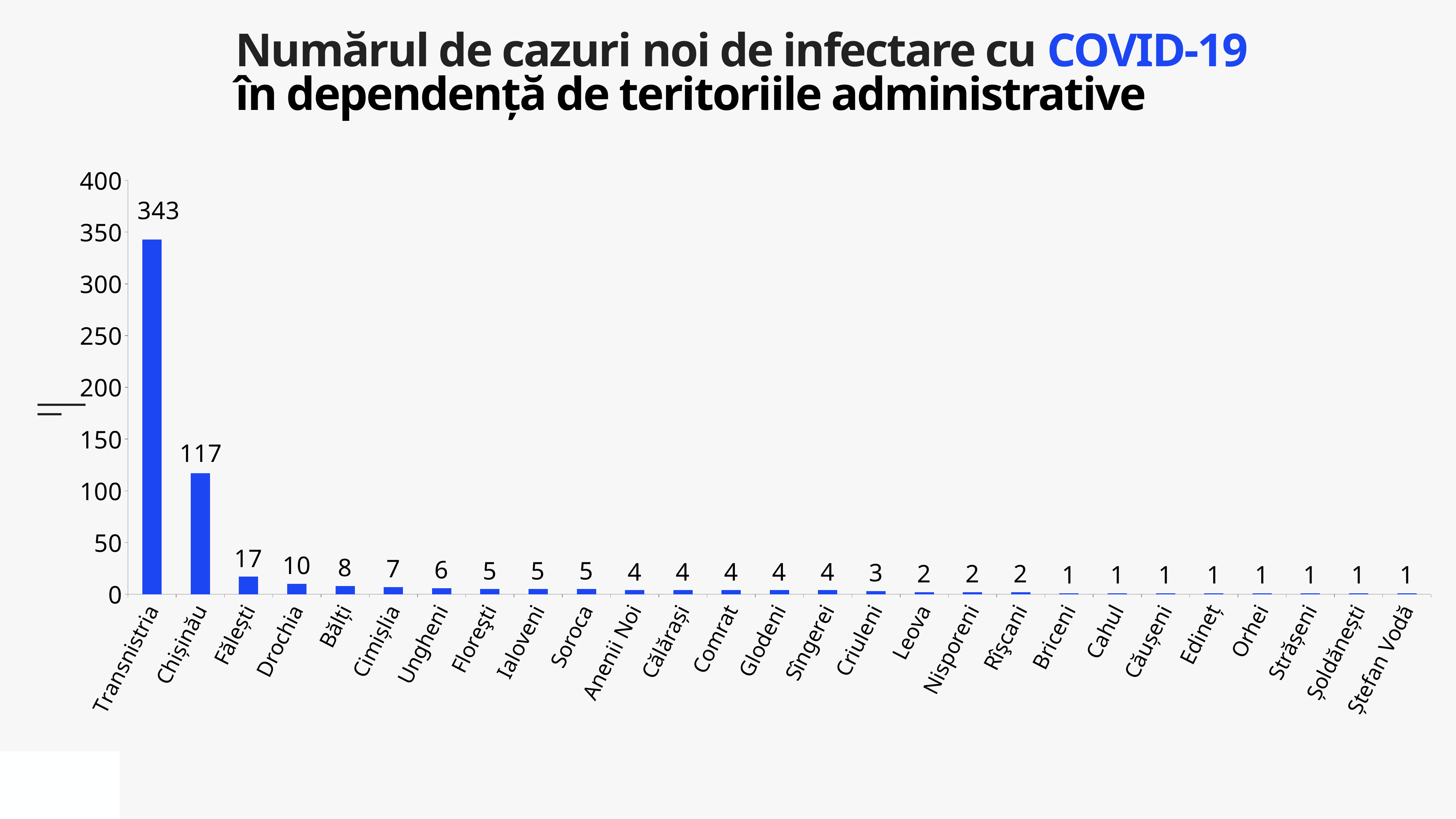
What kind of chart is shown on the slide? Bar chart What is the value shown for Fălești? 17 How many territories are shown on the x axis? 27 Which has a larger value, Bălți or Cimișlia? Bălți What is the value shown for Drochia? 10 What is the number of new cases for Chișinău? 117 What is the difference between the values for Fălești and Drochia? 7 What is the number of new cases for Transnistria? 343 Is the value for Transnistria greater or less than 300? greater What is the difference between the values for Transnistria and Chișinău? 226 Do the values rise or fall from left to right along the x axis? Fall Which territory has the highest number of new cases? Transnistria